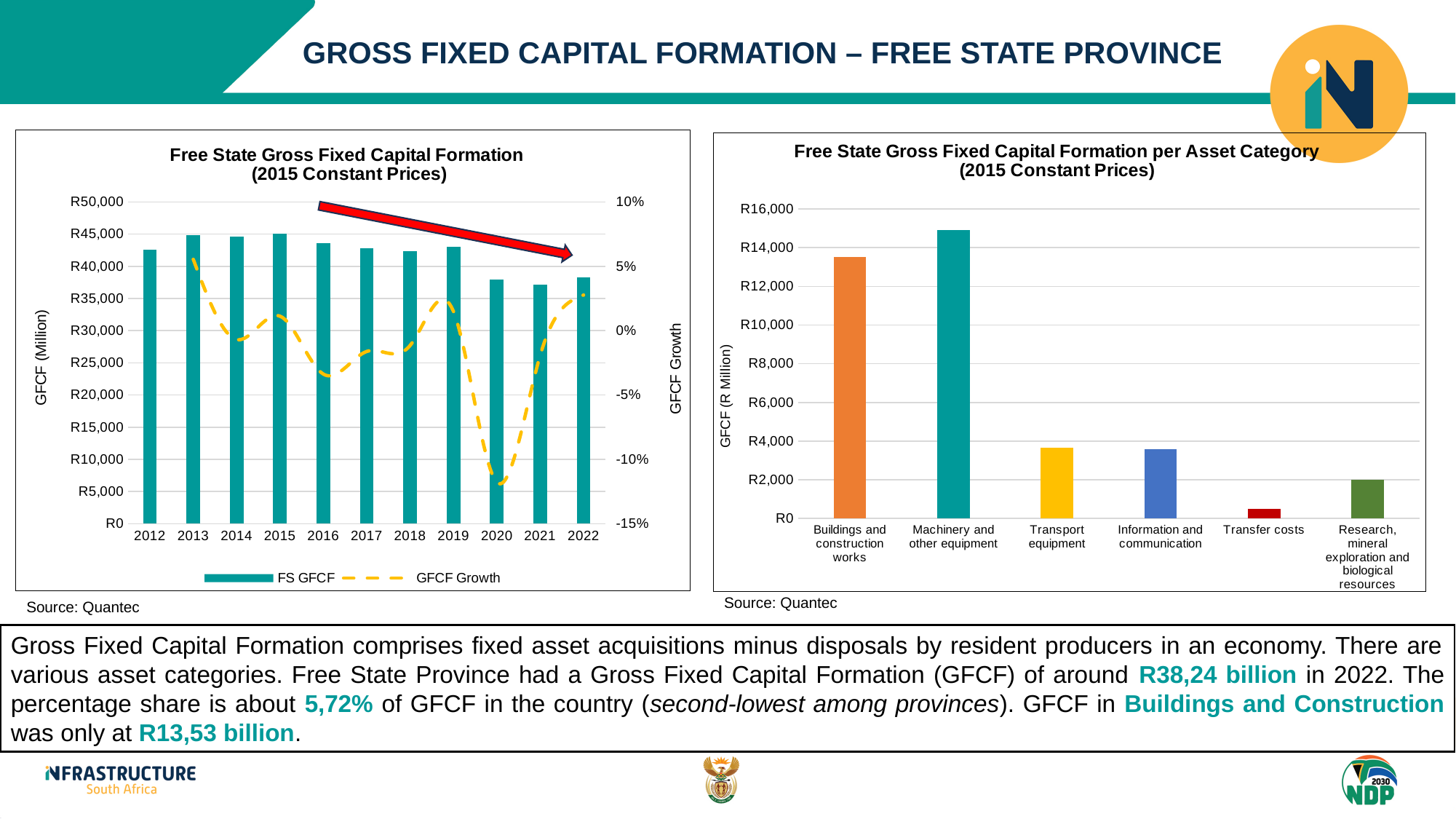
On the right chart (Free State Gross Fixed Capital Formation per Asset Category), which asset category has the highest value? Machinery and other equipment On the left chart (Free State Gross Fixed Capital Formation), is the FS GFCF value for 2012 greater or less than R40,000? greater On the right chart (Free State Gross Fixed Capital Formation per Asset Category), how many asset categories are shown? 6 What kind of chart is the right chart (Free State Gross Fixed Capital Formation per Asset Category)? bar chart On the right chart (Free State Gross Fixed Capital Formation per Asset Category), which is larger: Buildings and construction works or Machinery and other equipment? Machinery and other equipment On the left chart (Free State Gross Fixed Capital Formation), is the GFCF Growth value for 2020 greater or less than -10%? less On the left chart (Free State Gross Fixed Capital Formation), do the FS GFCF bars generally rise or fall from 2015 to 2021? fall On the right chart (Free State Gross Fixed Capital Formation per Asset Category), which asset category has the lowest value? Transfer costs On the left chart (Free State Gross Fixed Capital Formation), how many series does the legend list? 2 On the right chart (Free State Gross Fixed Capital Formation per Asset Category), is the value for Machinery and other equipment greater or less than R14,000? greater On the left chart (Free State Gross Fixed Capital Formation), how many years are shown on the x axis? 11